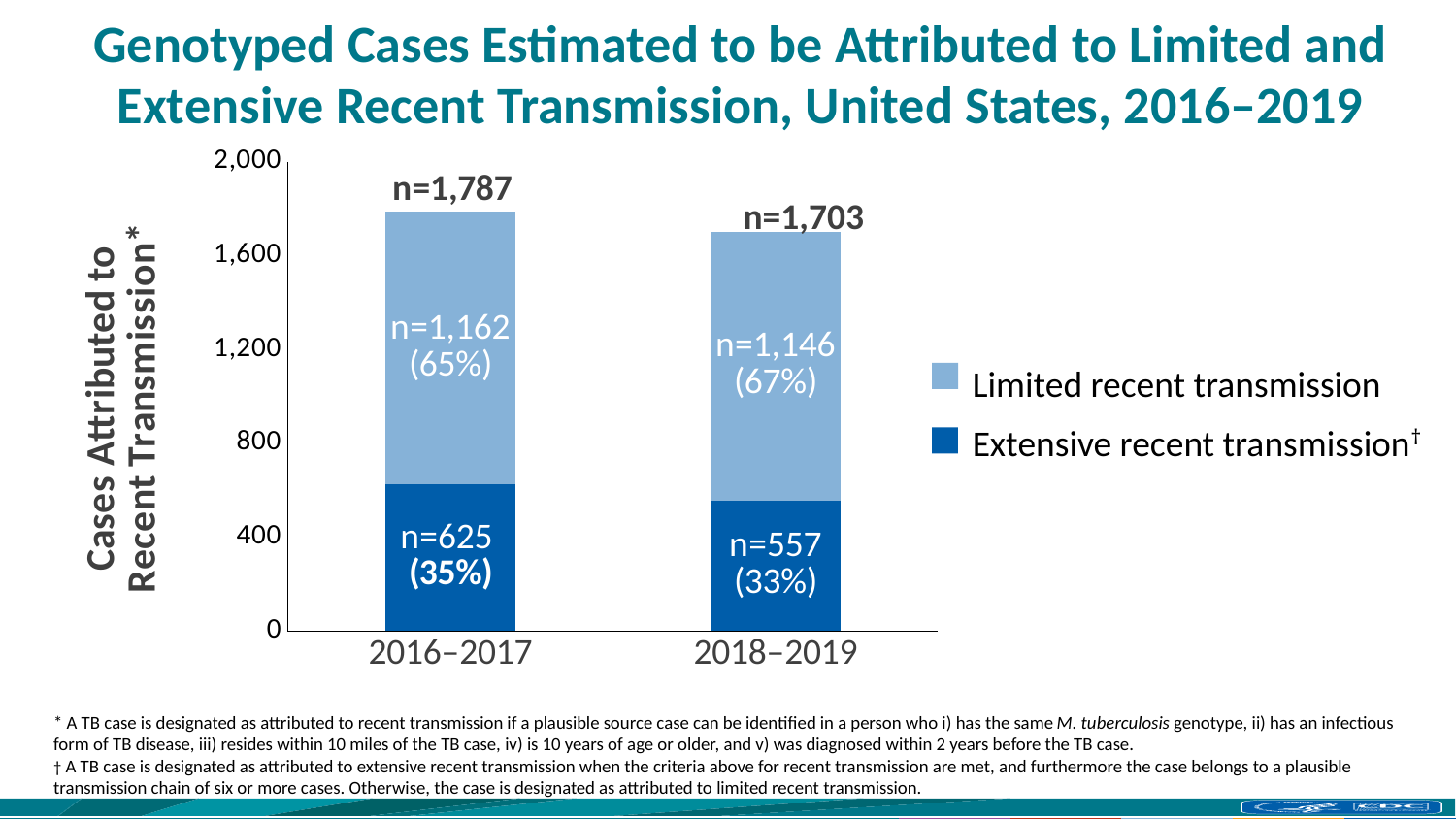
What is the total number of genotyped cases attributed to recent transmission for 2016–2017? 1,787 How many cases were attributed to limited recent transmission in 2016–2017? 1,162 What percentage of cases in 2016–2017 were attributed to extensive recent transmission? 35% How many series does the legend list? 2 How many cases were attributed to extensive recent transmission in 2018–2019? 557 Which period had the higher total number of cases attributed to recent transmission? 2016–2017 What is the difference in the number of extensive recent transmission cases between 2016–2017 and 2018–2019? 68 How many time periods are shown on the x axis? 2 What is the total number of genotyped cases attributed to recent transmission for 2018–2019? 1,703 What percentage of cases in 2018–2019 were attributed to limited recent transmission? 67% Which legend entry is shown in the darker blue colour? Extensive recent transmission What kind of chart is shown on the slide? Stacked bar chart